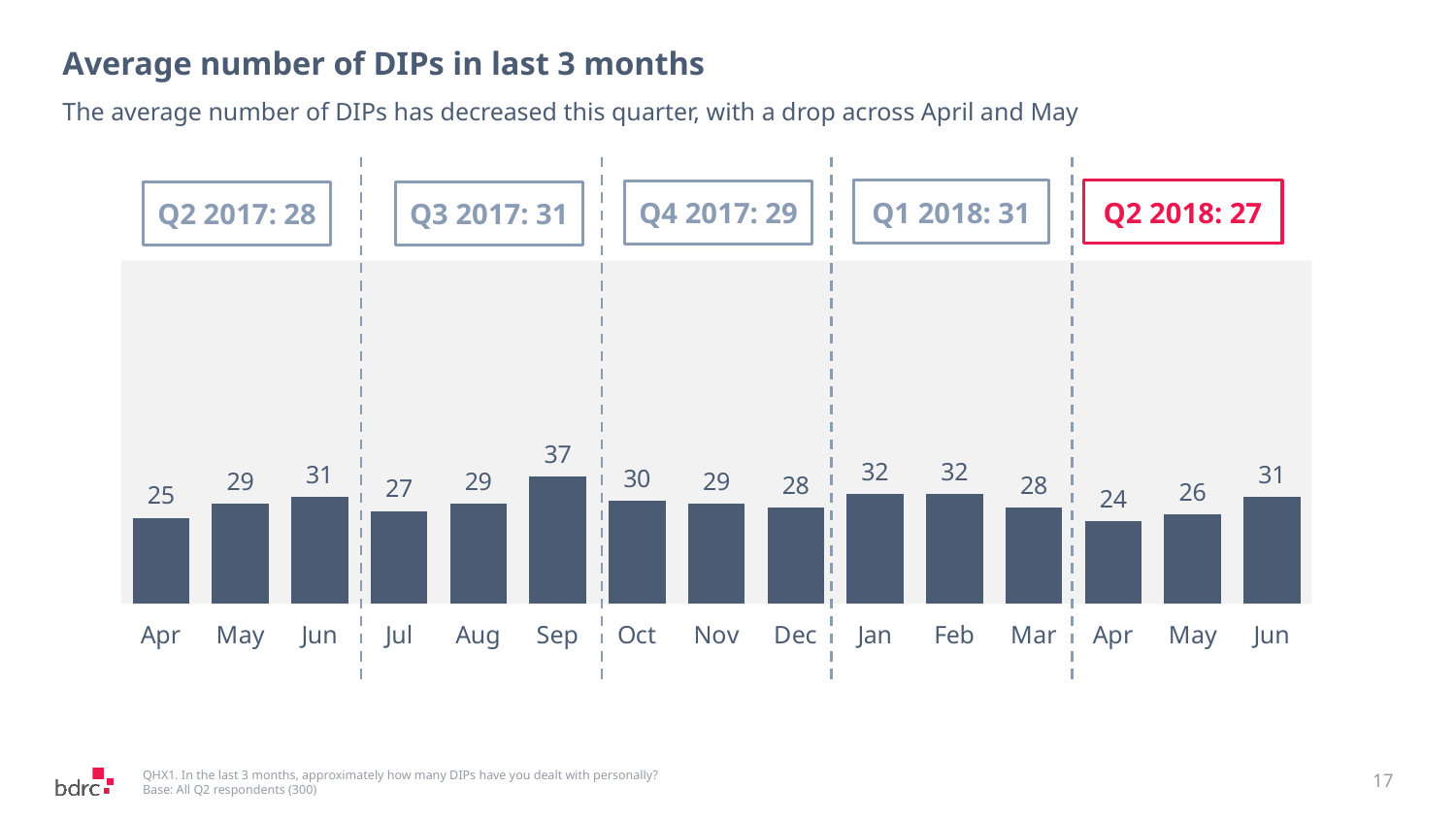
Do the values rise or fall from Apr to Jun in the Q2 2018 section? Rise What is the value for Apr in the Q2 2018 section of the chart? 24 Which month has the lowest value on the chart? Apr (Q2 2018) What is the quarterly average shown in the box for Q2 2018? 27 What is the value for Dec on the chart? 28 What is the difference between the values for Sep and Oct? 7 Which is larger, the value for Jan or the value for Mar? Jan How many bars are plotted on the chart? 15 What kind of chart is shown on the slide? Bar chart Which month has the highest value on the chart? Sep What is the value for Sep on the chart? 37 What is the title of the chart? Average number of DIPs in last 3 months